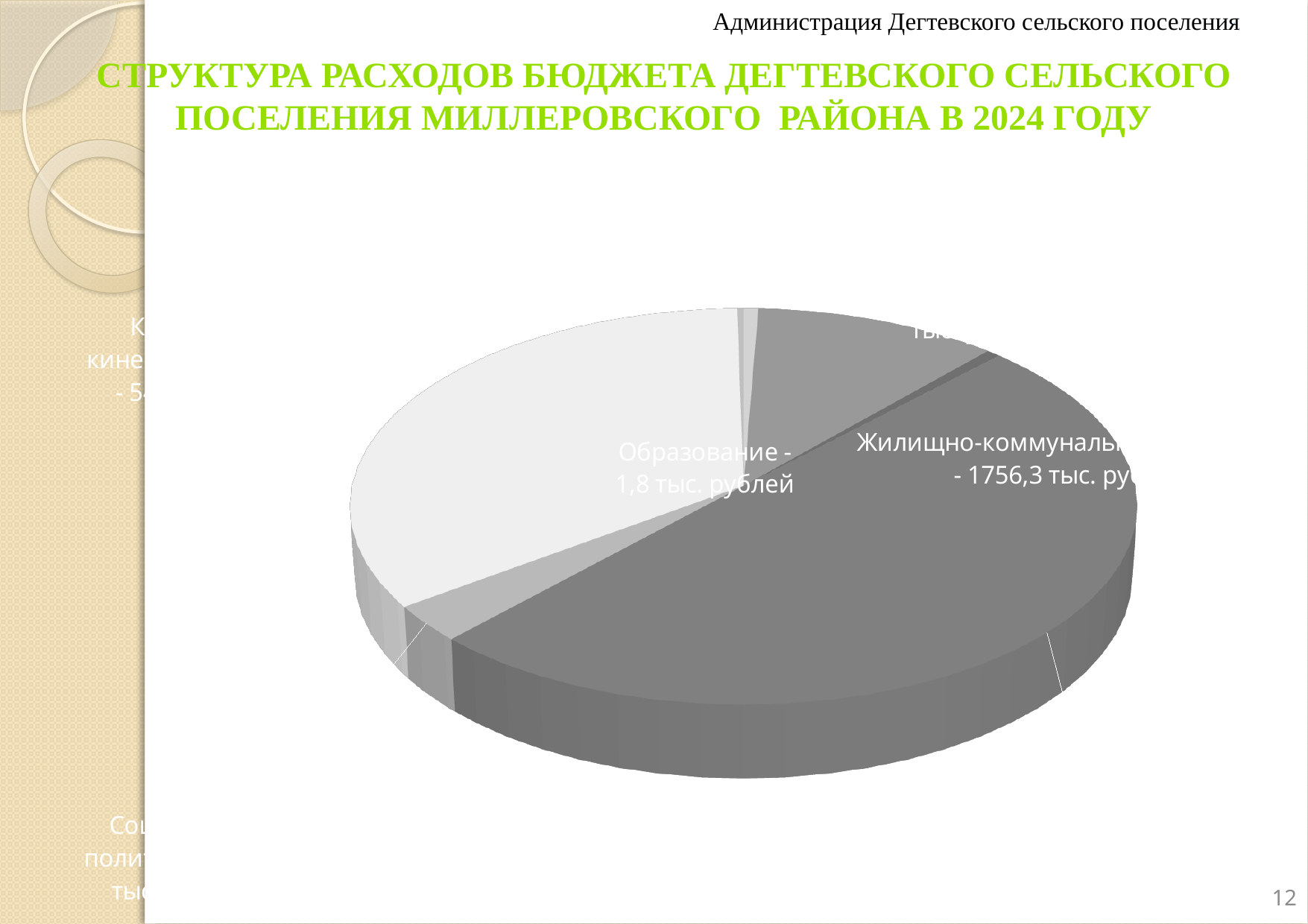
What is the value shown for Образование? 1,8 тыс. рублей What is the value shown for the Жилищно-коммунальное slice? 1756,3 тыс. рублей What is the title of the chart on the slide? Структура расходов бюджета Дегтевского сельского поселения Миллеровского района в 2024 году What kind of chart is shown on the slide? pie chart Which year does the chart title say the budget expenditure structure refers to? 2024 Which is larger, the value for Жилищно-коммунальное or the value for Образование? Жилищно-коммунальное